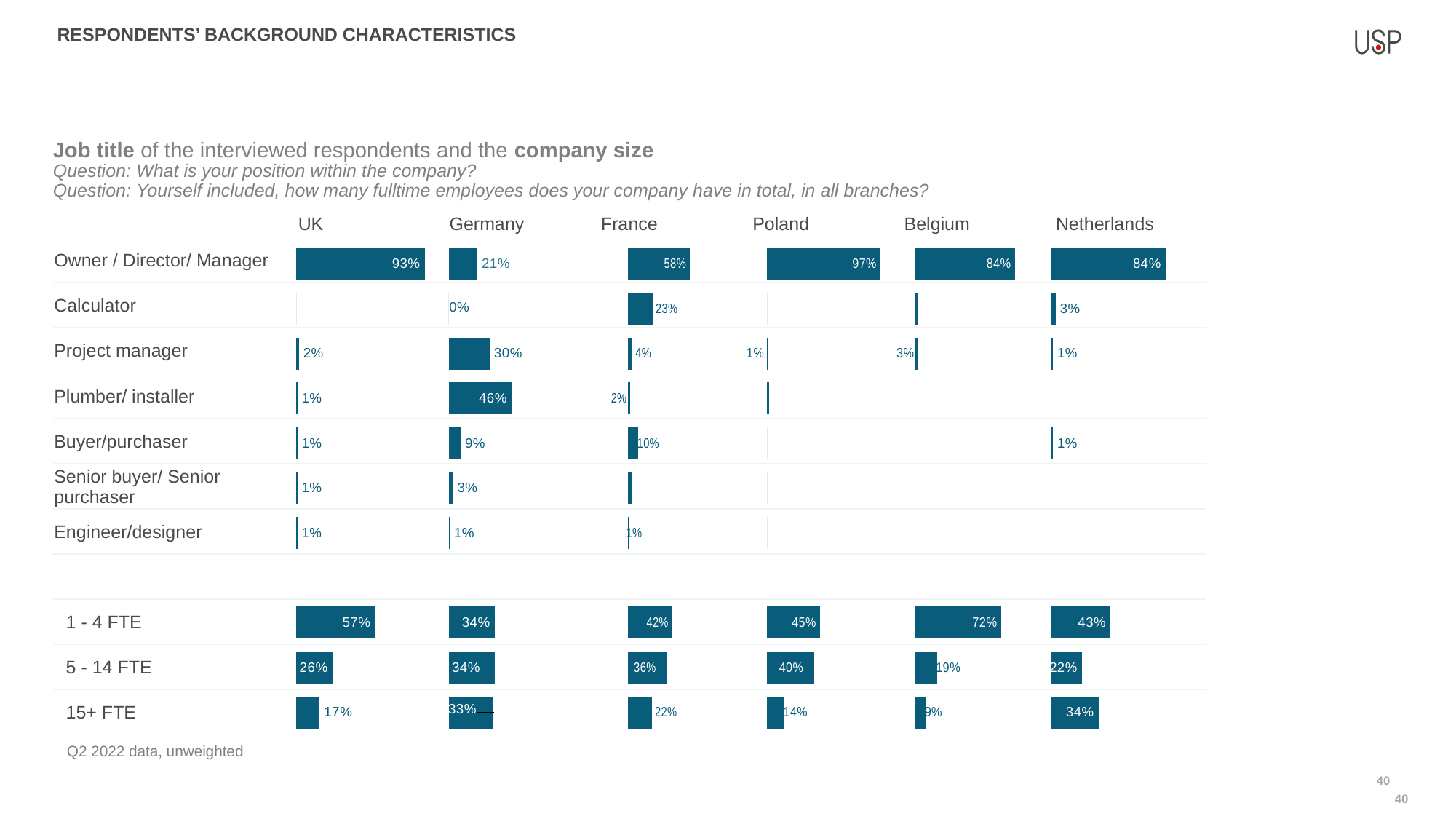
In the job title chart, what percentage of respondents in France are Calculator? 23% In the job title chart, which country has the highest share of Owner / Director / Manager respondents? Poland In the job title chart, what percentage of respondents in Poland are Owner / Director / Manager? 97% In the job title chart, which job title has the highest share among respondents in Germany? Plumber/ installer In the company size chart, which is larger: the 1 - 4 FTE share for Belgium or for the UK? Belgium In the company size chart, which country has the lowest share of 15+ FTE companies? Belgium In the company size chart, what is the total of the three FTE shares for the UK? 100% In the job title chart, what percentage of respondents in Germany are Plumber/ installer? 46% In the company size chart, what percentage of respondents in the Netherlands have 15+ FTE? 34% In the job title chart, what is the difference between the Owner / Director / Manager share in the UK and in Germany? 72 percentage points What kind of chart is used to show the job title and company size data? Bar chart How many countries are shown as columns in the charts? 6